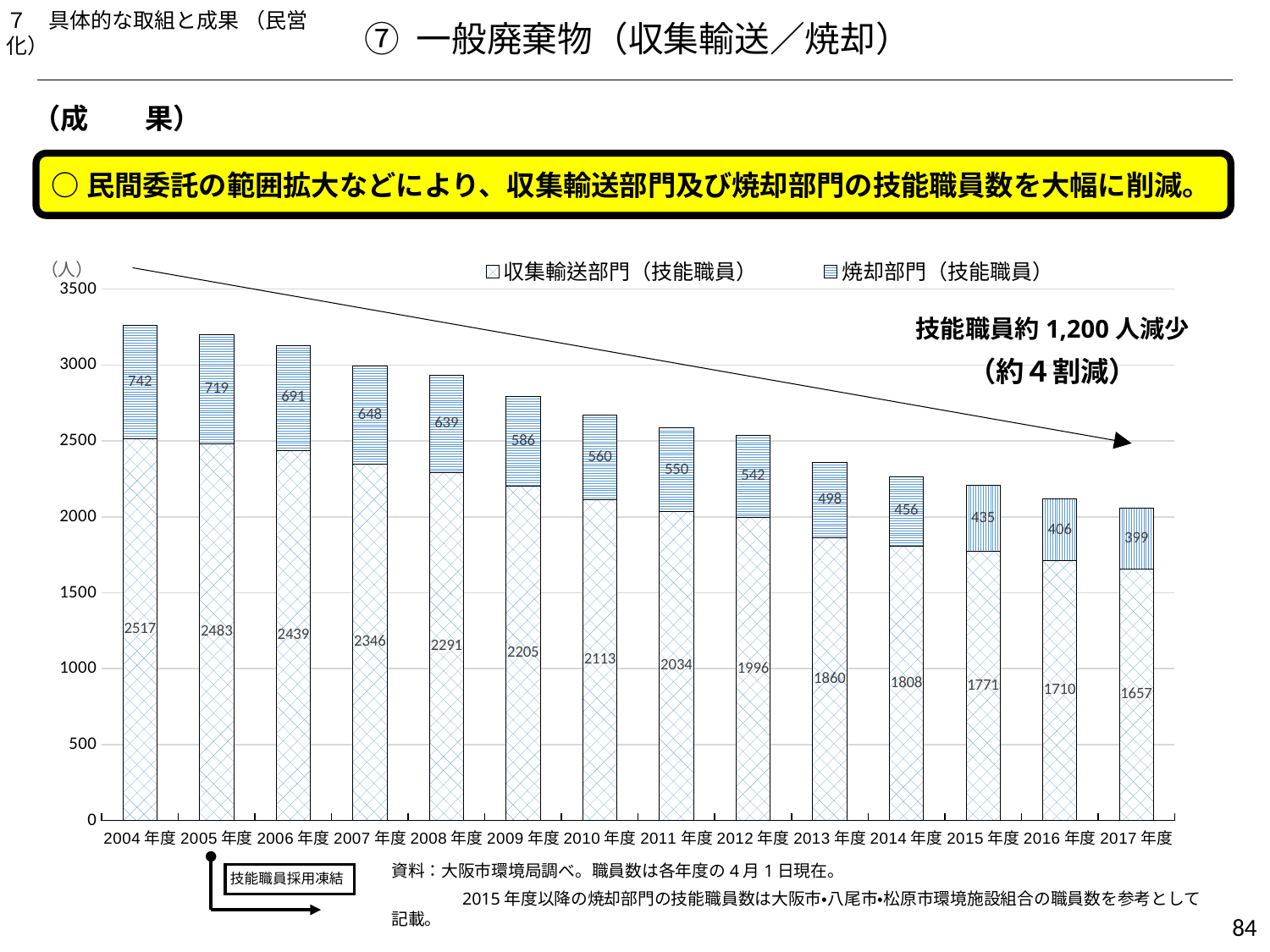
Which year has the highest value for 収集輸送部門（技能職員）? 2004 年度 What is the difference between the 収集輸送部門（技能職員） values for 2004 年度 and 2017 年度? 860 Do the 収集輸送部門（技能職員） values rise or fall from 2004 年度 to 2017 年度? fall What is the value for 収集輸送部門（技能職員） in 2004 年度? 2517 How many years (categories) are shown on the x axis? 14 How many series does the legend list? 2 Which is larger: the 焼却部門（技能職員） value in 2007 年度 or in 2012 年度? 2007 年度 What is the value for 焼却部門（技能職員） in 2017 年度? 399 What is the value for 焼却部門（技能職員） in 2009 年度? 586 What is the total of the stacked bar for 2017 年度? 2056 Which year has the lowest value for 焼却部門（技能職員）? 2017 年度 What is the total of the stacked bar for 2004 年度? 3259